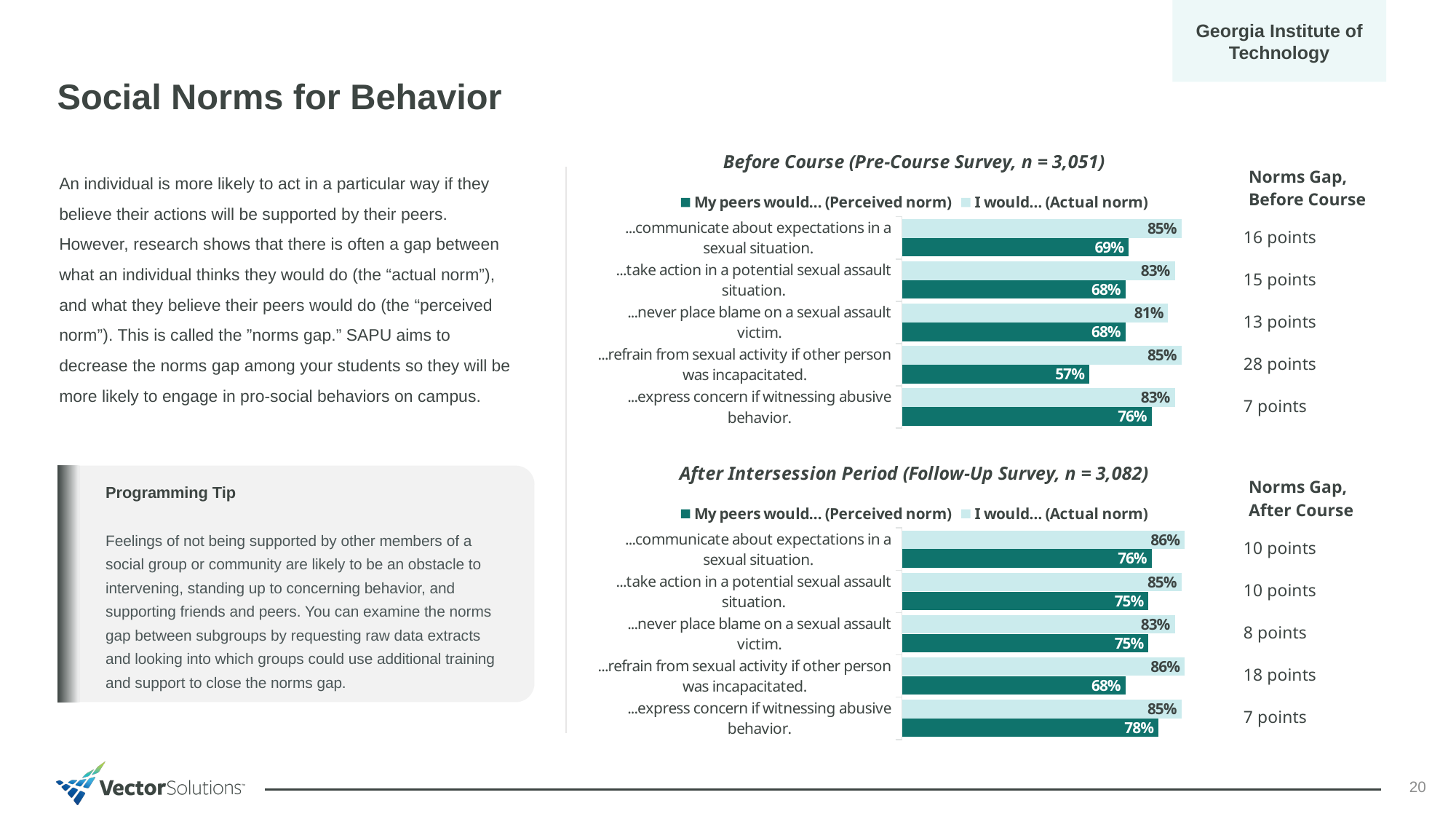
In the Before Course chart, which category has the highest "My peers would... (Perceived norm)" value? ...express concern if witnessing abusive behavior. In the After Intersession Period chart, what is the value for "I would... (Actual norm)" for "...never place blame on a sexual assault victim."? 83% In the Before Course chart, which category has the lowest "My peers would... (Perceived norm)" value? ...refrain from sexual activity if other person was incapacitated. In the After Intersession Period chart, what is the value for "My peers would... (Perceived norm)" for "...express concern if witnessing abusive behavior."? 78% How many series does the legend of the After Intersession Period chart list? 2 In the Before Course chart, what is the value for "My peers would... (Perceived norm)" for "...refrain from sexual activity if other person was incapacitated."? 57% In the Before Course chart, what is the difference between the "I would... (Actual norm)" and "My peers would... (Perceived norm)" values for "...take action in a potential sexual assault situation."? 15 points In the Before Course chart, what is the value for "I would... (Actual norm)" for "...communicate about expectations in a sexual situation."? 85% What kind of chart is the Before Course chart? Bar chart How many categories does the Before Course chart show? 5 In the After Intersession Period chart, what is the difference between the "I would... (Actual norm)" and "My peers would... (Perceived norm)" values for "...refrain from sexual activity if other person was incapacitated."? 18 points In the After Intersession Period chart, which is larger: the "My peers would... (Perceived norm)" value for "...communicate about expectations in a sexual situation." or for "...refrain from sexual activity if other person was incapacitated."? ...communicate about expectations in a sexual situation.